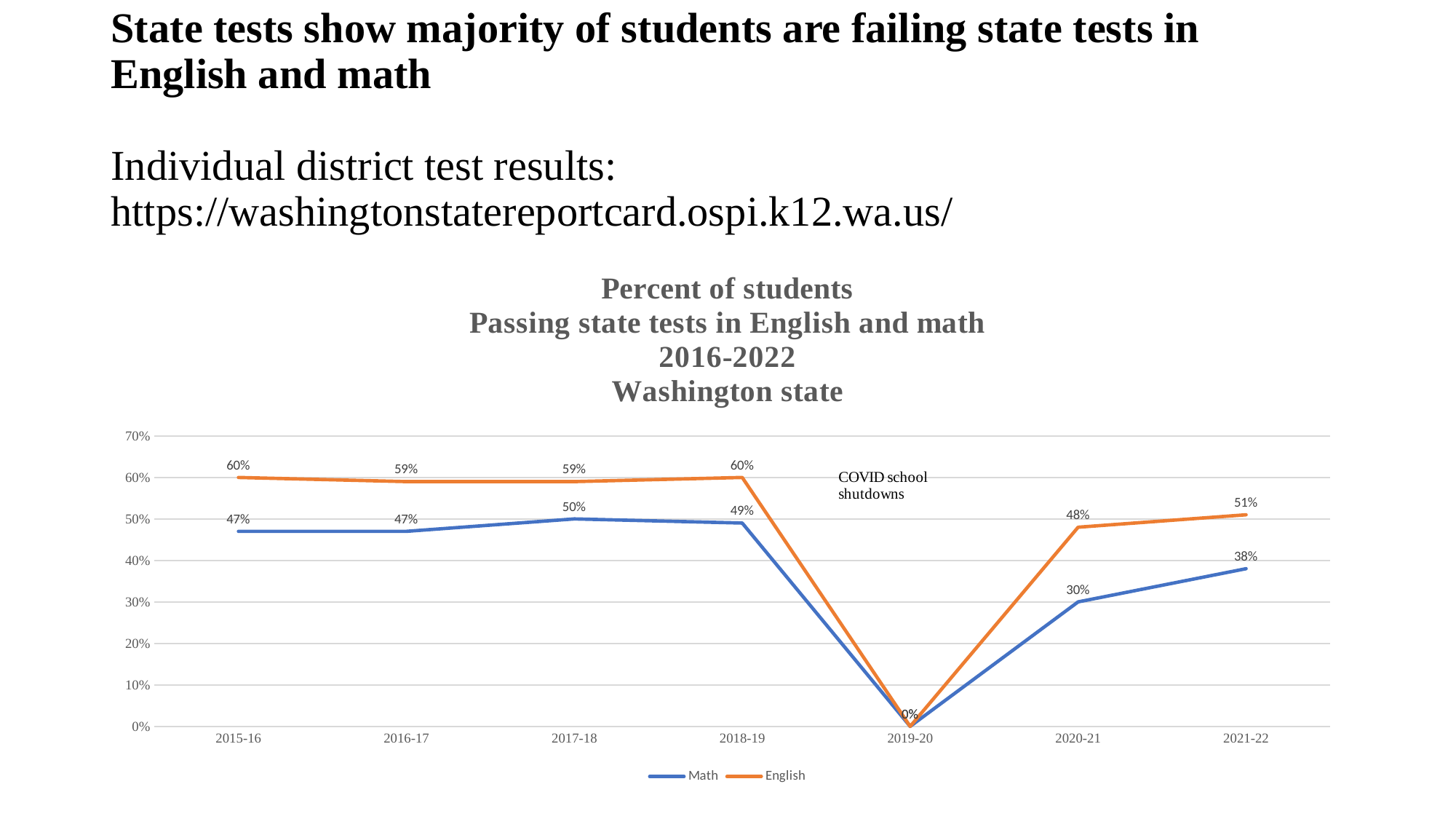
Which colour represents the English series in the chart? Orange What percent of students passed the English state test in 2021-22? 51% How many school years are shown on the x axis? 7 In which school year was the English passing rate lowest? 2019-20 How many series does the legend list? 2 Which series had the higher passing rate in 2021-22, Math or English? English Did the math passing rate rise or fall from 2020-21 to 2021-22? Rise What was the math passing rate in 2020-21? 30% What annotation is written near the 2019-20 data point? COVID school shutdowns What percent of students passed the math state test in 2017-18? 50% What is the difference between the English and math passing rates in 2015-16? 13% What kind of chart is shown on the slide? Line chart